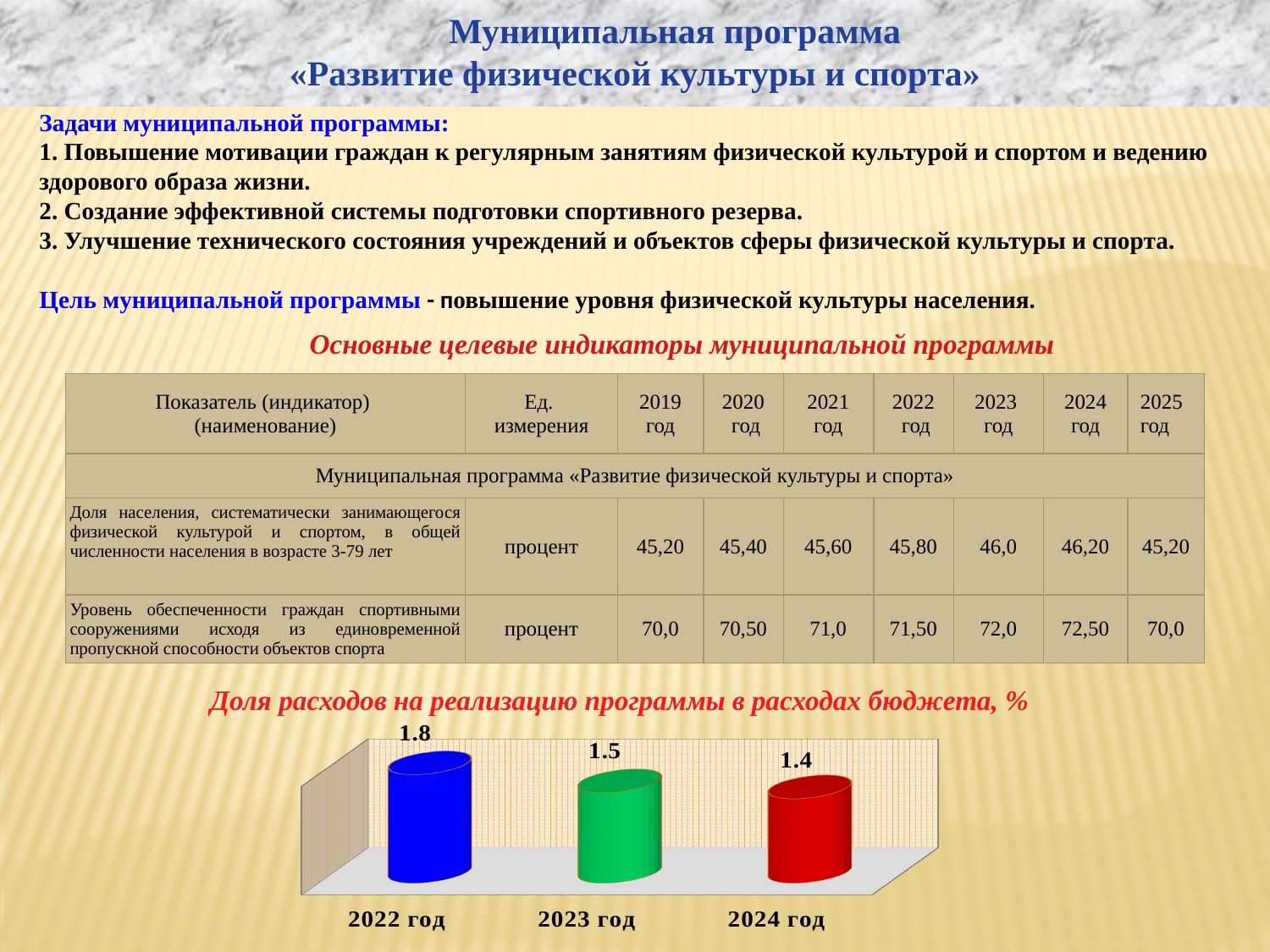
Which is larger, the value for 2023 год or the value for 2024 год? 2023 год How many years are shown in the chart? 3 What is the difference between the values for 2022 год and 2024 год? 0.4 What is the difference between the values for 2022 год and 2023 год? 0.3 Which year has the highest value in the chart? 2022 год What kind of chart is shown at the bottom of the slide? Bar chart Which year has the lowest value in the chart? 2024 год What is the value for 2024 год in the chart? 1.4 What is the title of the chart at the bottom of the slide? Доля расходов на реализацию программы в расходах бюджета, % Do the values in the chart rise or fall from 2022 год to 2024 год? Fall What is the value for 2022 год in the chart? 1.8 What is the value for 2023 год in the chart? 1.5